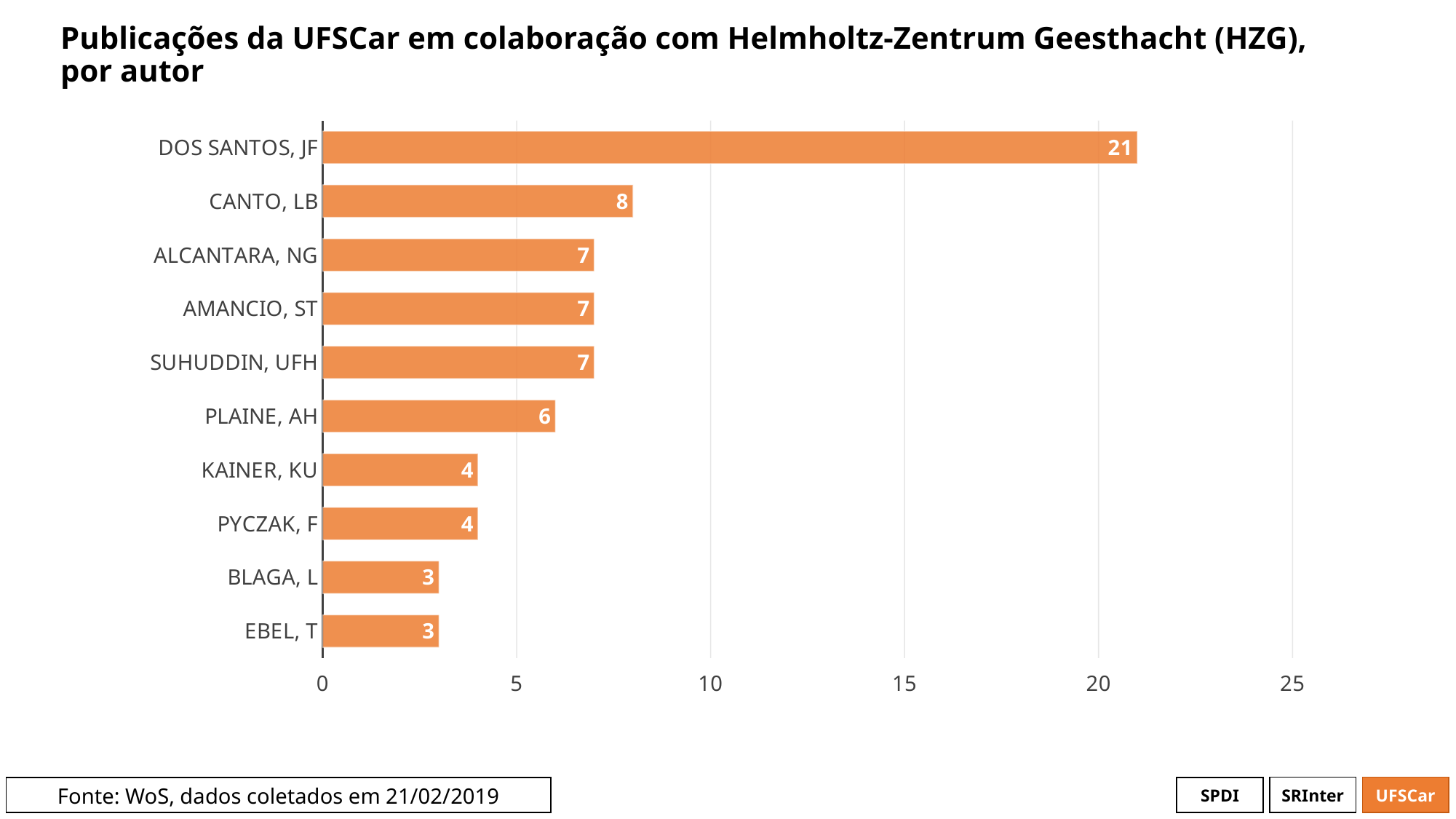
Is the value for DOS SANTOS, JF greater or less than 20? greater Which is larger, the value for KAINER, KU or the value for PLAINE, AH? PLAINE, AH What is the value for PLAINE, AH? 6 What is the difference between the values for DOS SANTOS, JF and CANTO, LB? 13 How many authors are shown in the chart? 10 What kind of chart is shown on the slide? bar chart Which author has the highest number of publications? DOS SANTOS, JF What is the title of the chart? Publicações da UFSCar em colaboração com Helmholtz-Zentrum Geesthacht (HZG), por autor What is the value for EBEL, T? 3 How many publications does DOS SANTOS, JF have? 21 How many authors have a value of 7? 3 What is the value for CANTO, LB? 8